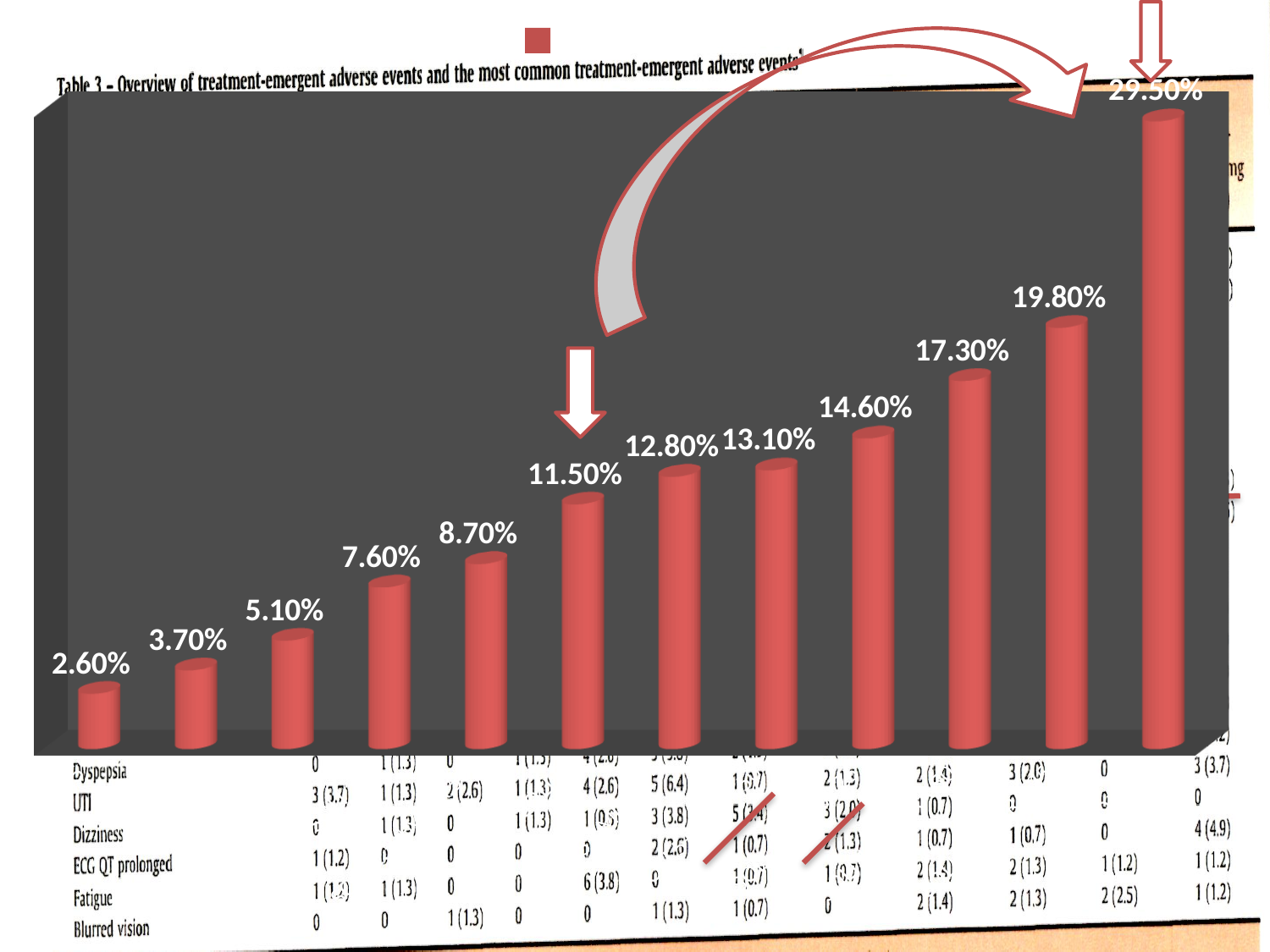
What is the difference between the bars labelled 13.10% and 12.80%? 0.30% What is the difference between the rightmost bar (29.50%) and the second bar from the right (19.80%)? 9.70% How many bars does the chart contain? 12 What is the value shown on the tallest bar? 29.50% Do the bar values rise or fall from left to right across the chart? rise What value is labelled on the leftmost bar? 2.60% What colour are the bars in the chart? red What kind of chart is shown on the slide? bar chart What value is labelled on the sixth bar from the left, the one the white downward arrow points to? 11.50% What is the value shown on the shortest bar? 2.60% What value is labelled on the second bar from the right? 19.80% What value is labelled on the third bar from the left? 5.10%